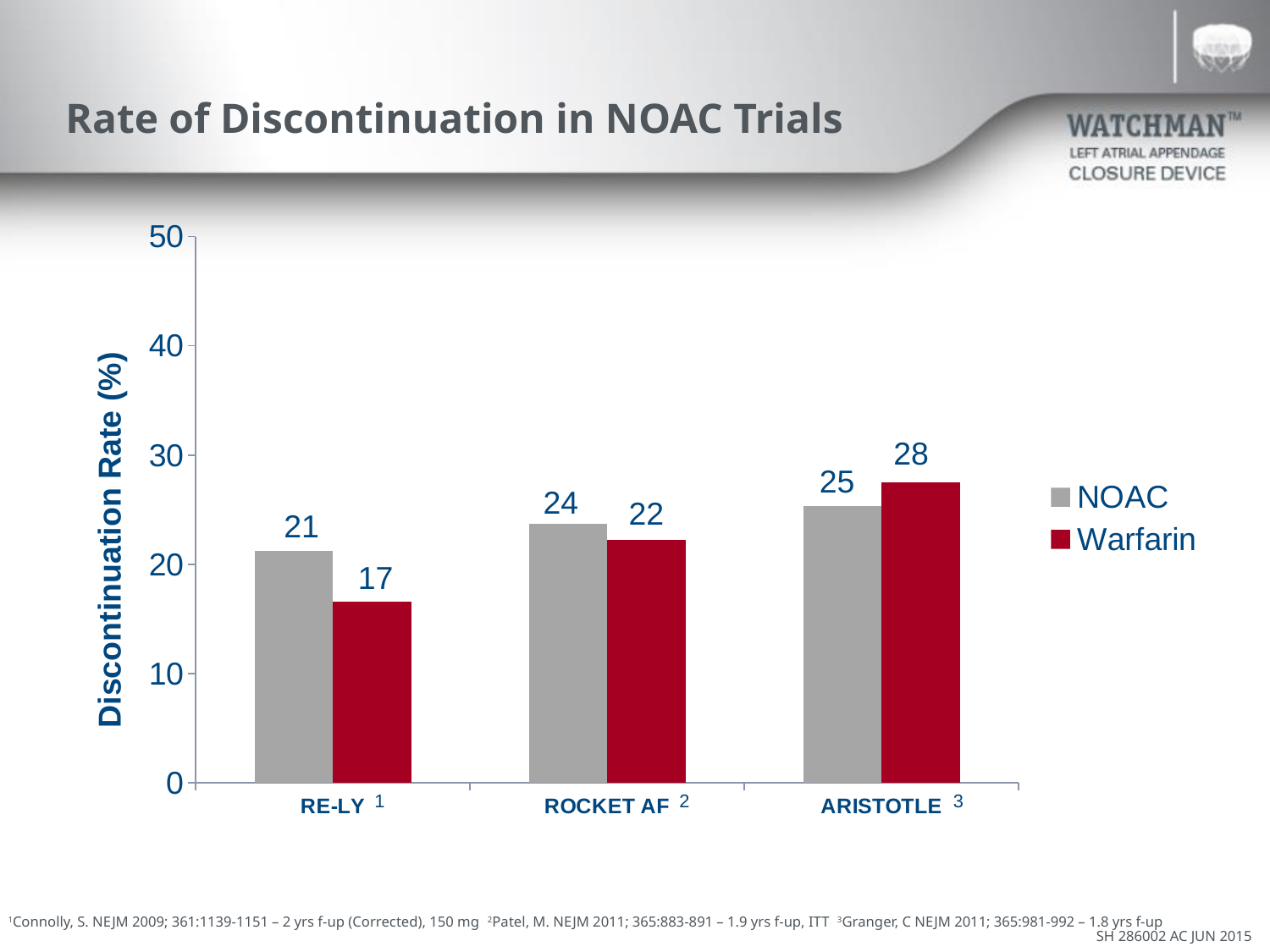
Which trial has the lowest NOAC discontinuation rate? RE-LY What kind of chart is shown on the slide? bar chart How many trials are shown on the x axis? 3 What is the title of the y axis? Discontinuation Rate (%) What is the NOAC discontinuation rate for RE-LY? 21 Is the Warfarin discontinuation rate for RE-LY greater or less than 20? less What is the Warfarin discontinuation rate for ARISTOTLE? 28 Which trial has the highest Warfarin discontinuation rate? ARISTOTLE What is the Warfarin discontinuation rate for ROCKET AF? 22 In ROCKET AF, which is larger: the NOAC or the Warfarin discontinuation rate? NOAC What is the difference between the NOAC and Warfarin discontinuation rates in RE-LY? 4 How many series does the legend list? 2